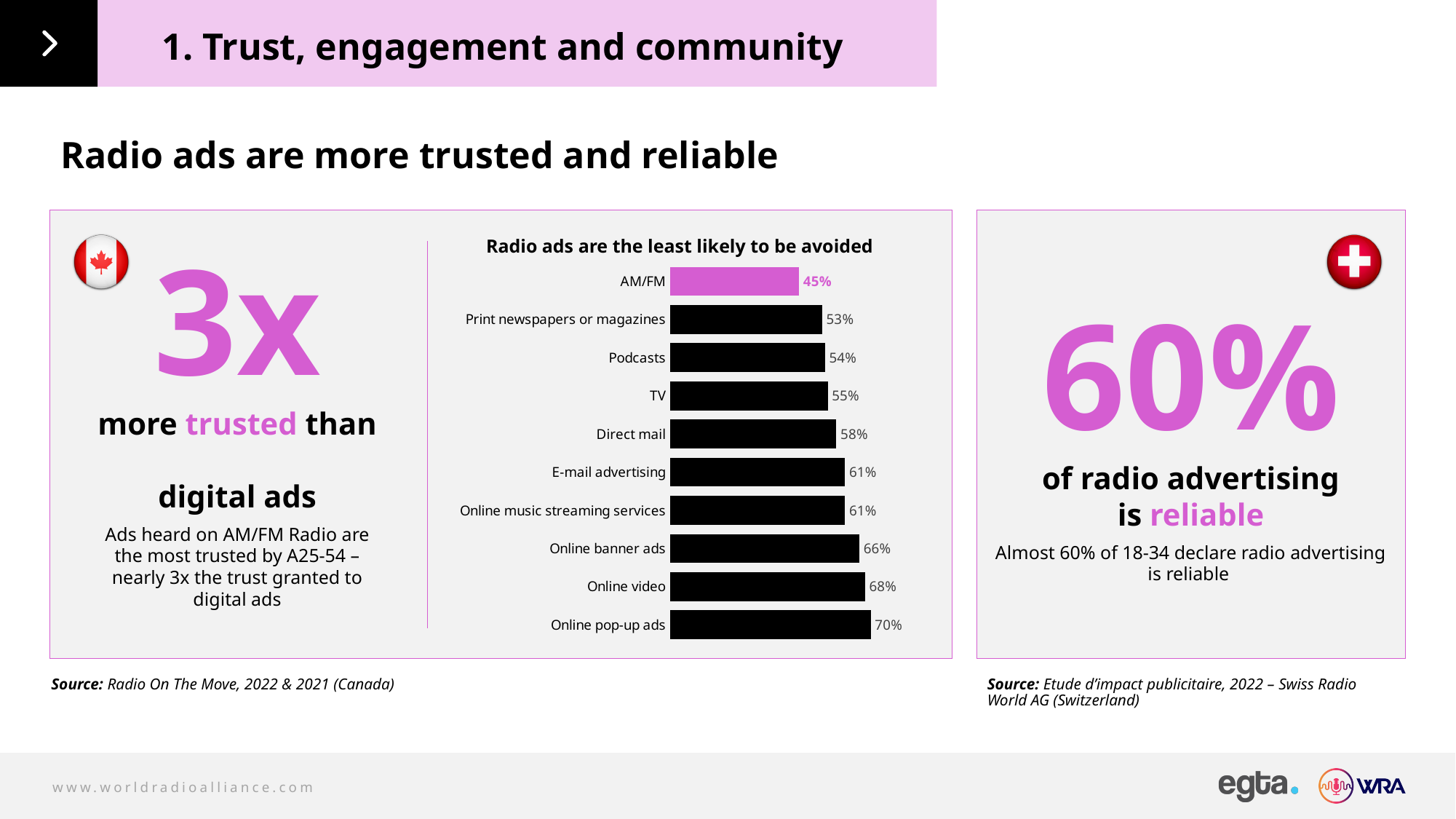
Which has a larger value, Podcasts or Online video? Online video What is the difference between the values for Online pop-up ads and AM/FM? 25% What is the value for Online banner ads in the chart? 66% What is the title of the chart on the slide? Radio ads are the least likely to be avoided What is the difference between the values for Online video and TV? 13% What is the value for Direct mail in the chart? 58% What is the value for AM/FM in the chart 'Radio ads are the least likely to be avoided'? 45% Which category has the lowest value in the chart? AM/FM What kind of chart is shown on the slide? Bar chart How many categories are shown in the chart? 10 What is the value for Online pop-up ads in the chart? 70% Which category has the highest value in the chart? Online pop-up ads